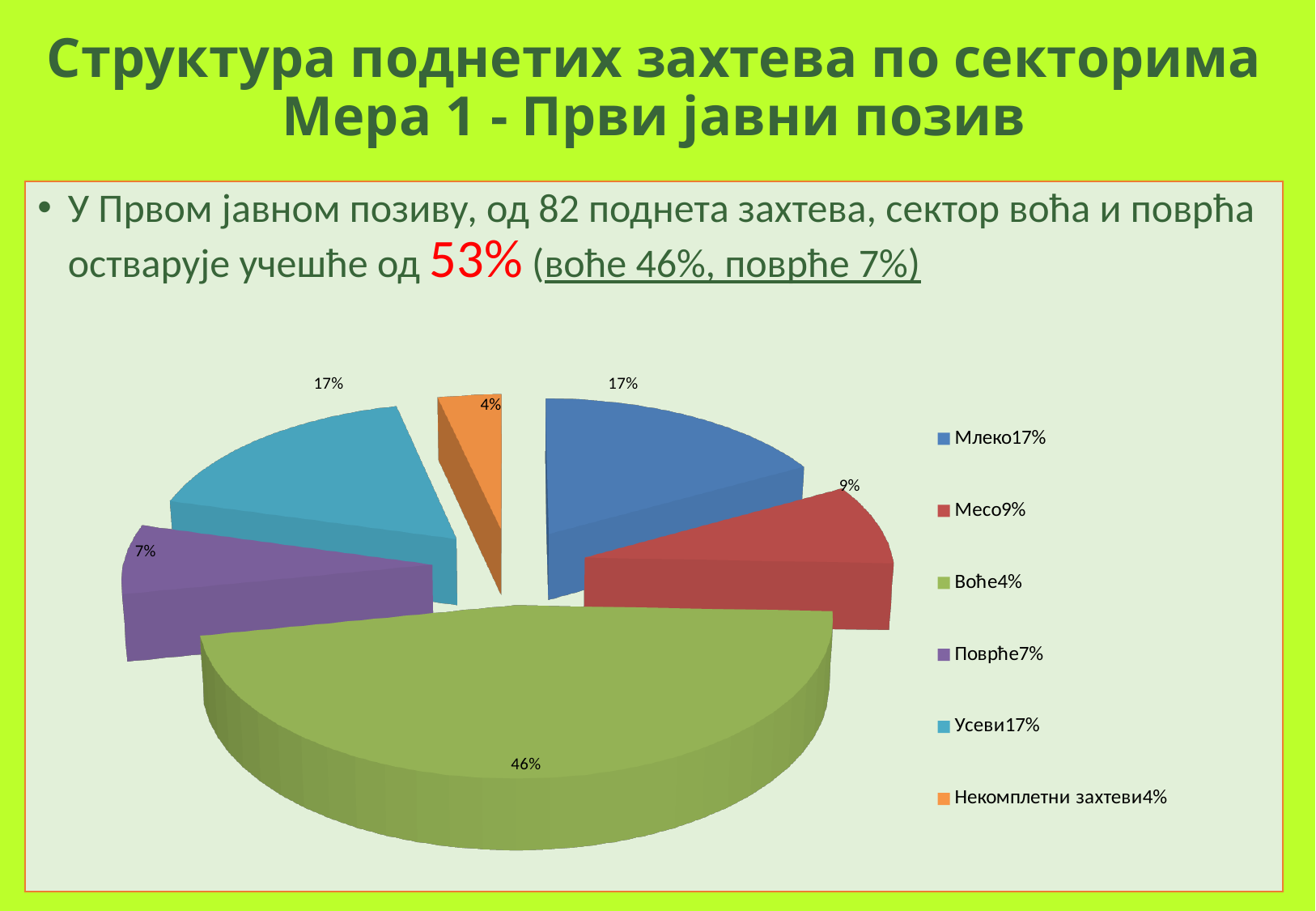
Which category has the smallest slice of the pie? Некомплетни захтеви What is the value for Некомплетни захтеви in the pie chart? 4% What colour is the Воће slice in the pie chart? green What is the difference between the values for Млеко and Месо? 8 percentage points How many categories does the pie chart have? 6 What share of the pie does Воће have? 46% What is the value for Месо in the pie chart? 9% Which category has the largest slice of the pie? Воће What is the value for Усеви in the pie chart? 17% What kind of chart is shown on the slide? pie chart Which is larger, the slice for Усеви or the slice for Поврће? Усеви What is the value for Поврће in the pie chart? 7%